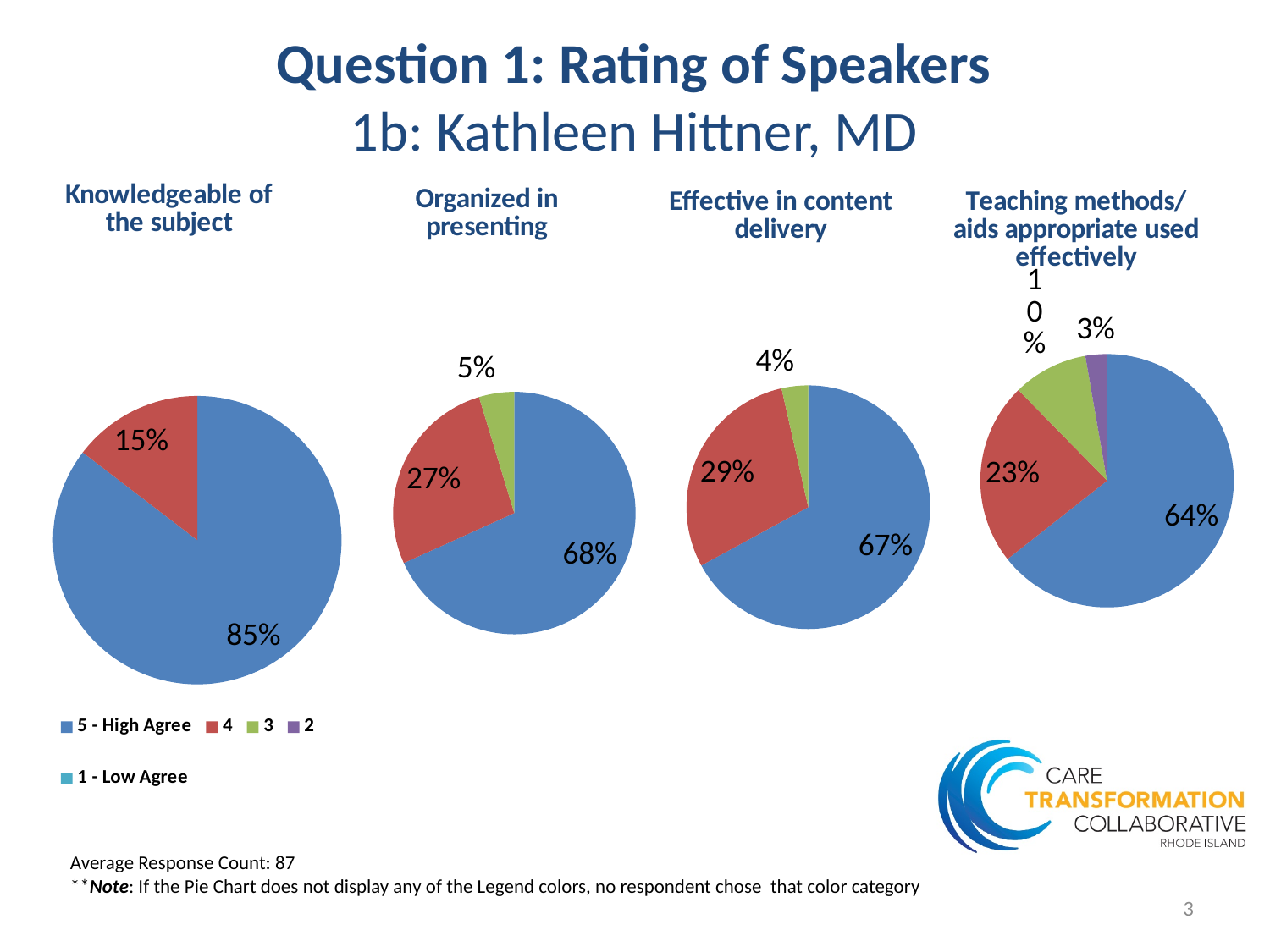
In the 'Organized in presenting' pie chart, which rating has the smallest slice? 3 In the 'Teaching methods/aids appropriate used effectively' pie chart, what share of respondents chose '2'? 3% In the 'Effective in content delivery' pie chart, what is the difference between the '5 - High Agree' share and the '4' share? 38% In the 'Teaching methods/aids appropriate used effectively' pie chart, which rating has the largest slice? 5 - High Agree In the 'Knowledgeable of the subject' pie chart, what share of respondents chose '5 - High Agree'? 85% How many entries does the legend list? 5 In the 'Knowledgeable of the subject' pie chart, what share of respondents chose '4'? 15% In the 'Organized in presenting' pie chart, what share of respondents chose '3'? 5% Which is larger: the '5 - High Agree' share in the 'Organized in presenting' chart or in the 'Effective in content delivery' chart? Organized in presenting In the 'Effective in content delivery' pie chart, what share of respondents chose '4'? 29% What kind of chart is used for 'Knowledgeable of the subject'? Pie chart How many slices does the 'Teaching methods/aids appropriate used effectively' pie chart have? 4